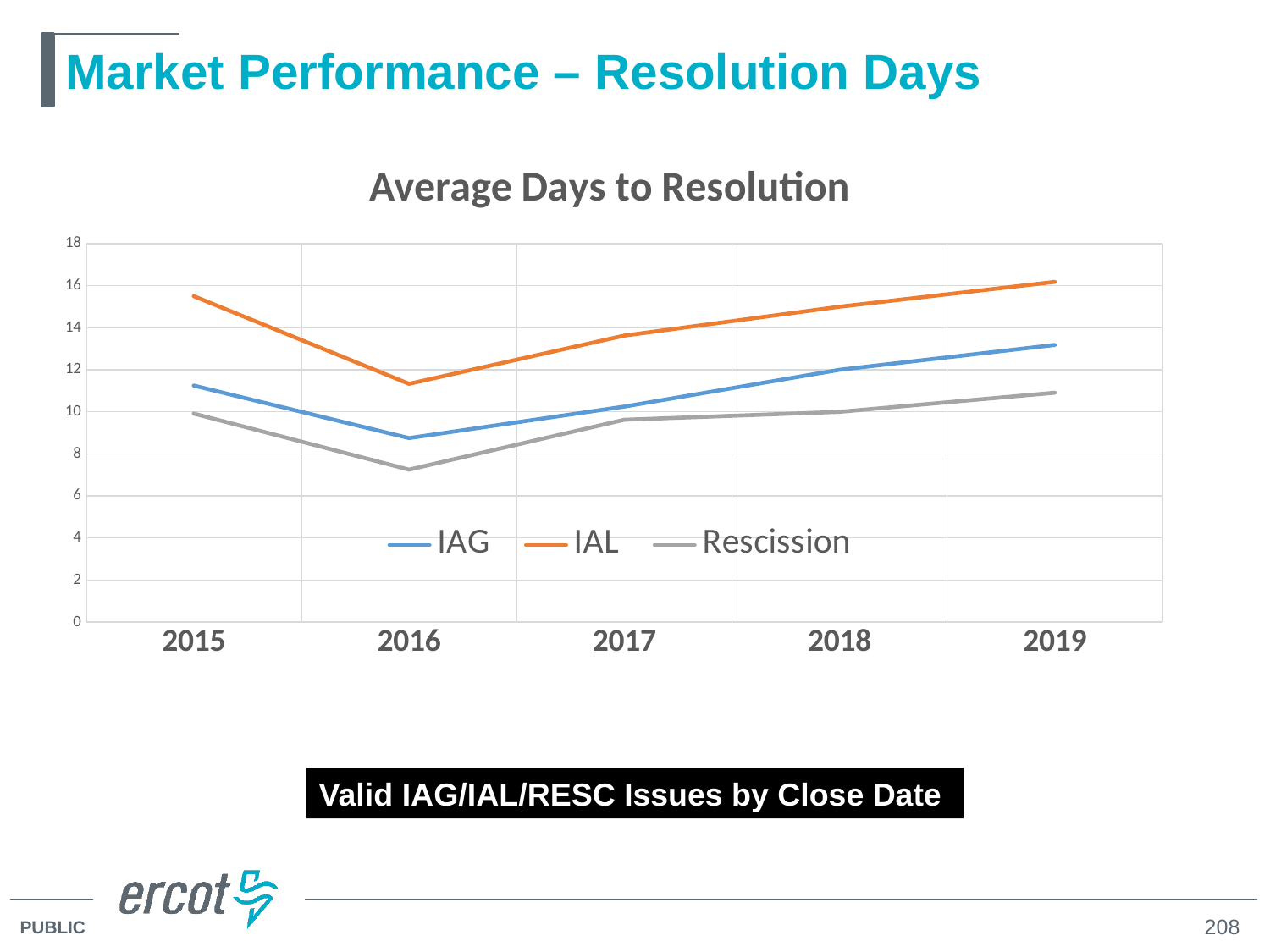
What kind of chart is shown on the slide? Line chart Is the value for IAL in 2015 greater or less than 14? greater Which series has the lowest value in 2016? Rescission In which year is the IAL line at its highest? 2019 Which is larger in 2018, the IAG value or the Rescission value? IAG How many series does the legend list? 3 Do the IAL values rise or fall from 2016 to 2019? Rise In which year is the IAL line at its lowest? 2016 Which series has the highest average days to resolution in 2017? IAL How many years are shown on the x axis? 5 Is the value for IAG in 2016 greater or less than 10? less Is the value for Rescission in 2016 greater or less than 8? less